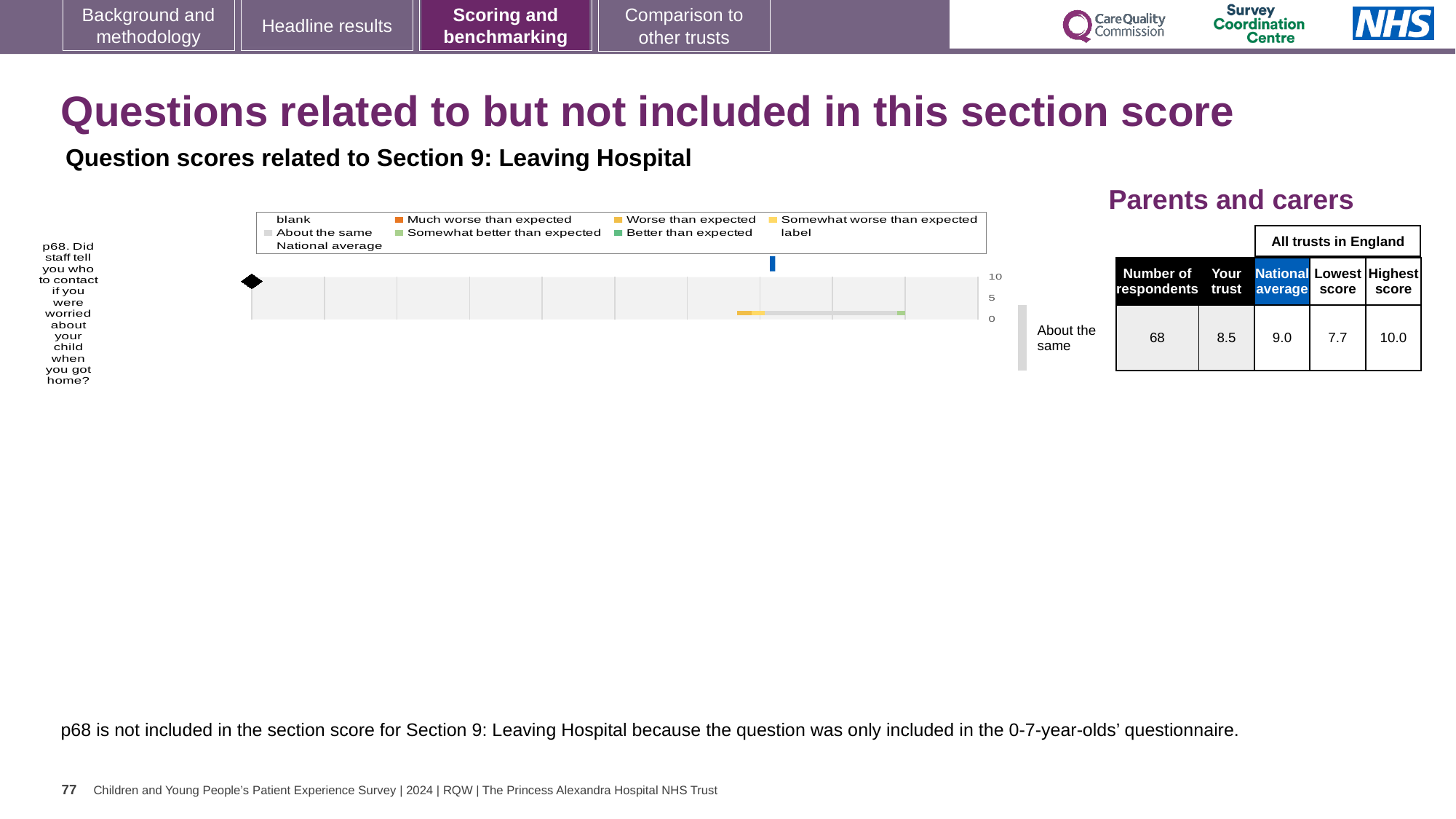
What is the 'Your trust' score for p68 in the accompanying table? 8.5 How many questions (categories) are plotted in the chart? 1 What is the number of respondents for p68? 68 Which is larger for p68, the trust's score or the national average? national average What is the highest score among all trusts in England for p68? 10.0 What is the lowest score among all trusts in England for p68? 7.7 What is the difference between the highest and lowest scores for p68 across all trusts in England? 2.3 How many entries does the chart legend list? 9 What is the difference between the national average and the trust's score for p68? 0.5 Which benchmark category label is shown next to the bar for p68? About the same What is the national average score for p68 in the accompanying table? 9.0 What kind of chart is shown for question p68? bar chart